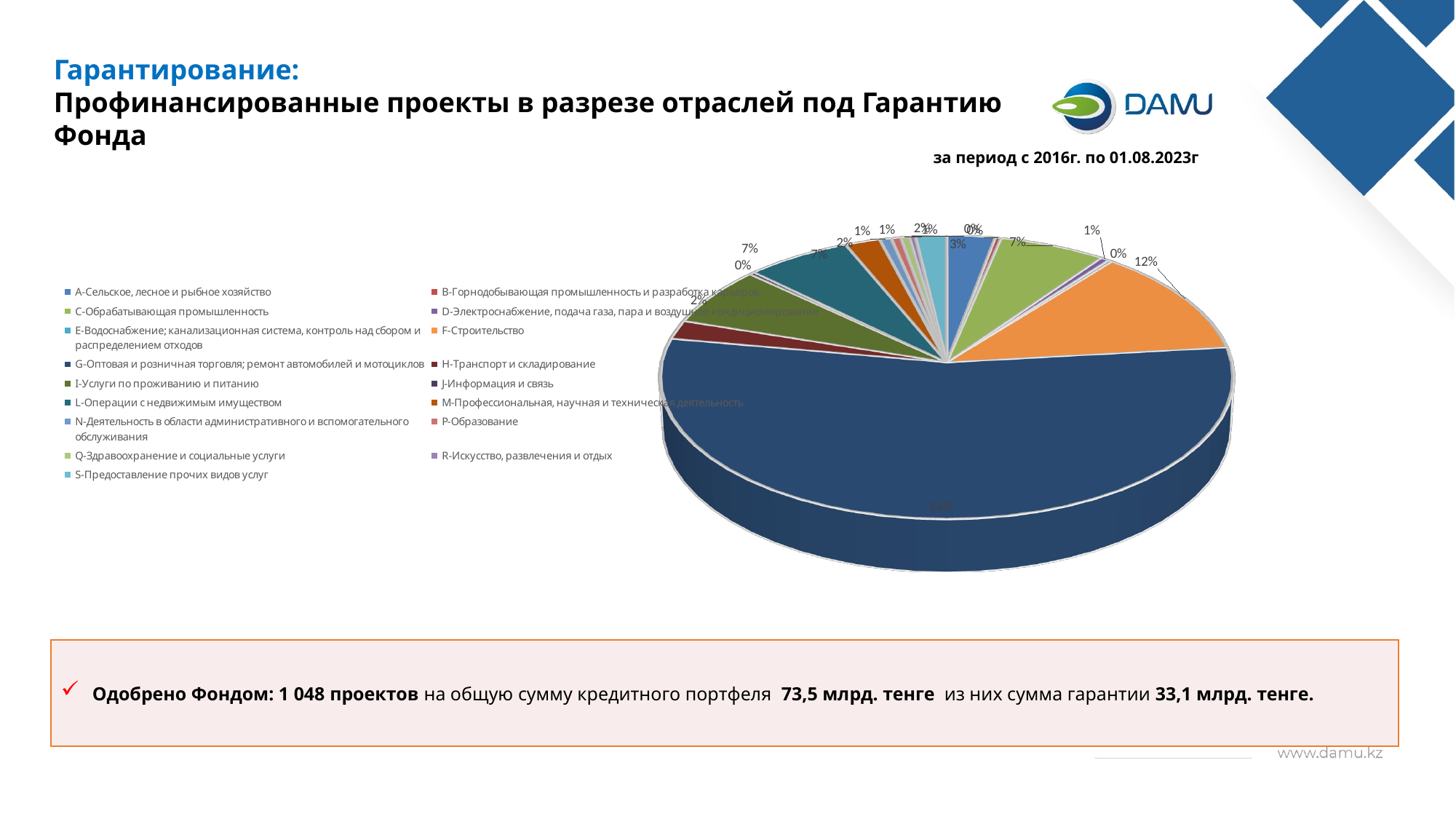
What period does the chart cover, according to the text above it? за период с 2016г. по 01.08.2023г What colour is the largest slice of the pie chart? dark blue What share of the pie does F-Строительство have? 12% What share of the pie does C-Обрабатывающая промышленность have? 7% Which category has the largest slice of the pie chart? G-Оптовая и розничная торговля; ремонт автомобилей и мотоциклов What share of the pie does A-Сельское, лесное и рыбное хозяйство have? 3% Which is larger, the slice for F-Строительство or the slice for C-Обрабатывающая промышленность? F-Строительство What kind of chart is shown on the slide? pie chart How many categories does the legend of the pie chart list? 17 Which is larger, the slice for G-Оптовая и розничная торговля or the slice for F-Строительство? G-Оптовая и розничная торговля; ремонт автомобилей и мотоциклов Is the share for G-Оптовая и розничная торговля greater or less than 50%? greater What is the difference in percentage points between the shares of F-Строительство and C-Обрабатывающая промышленность? 5%